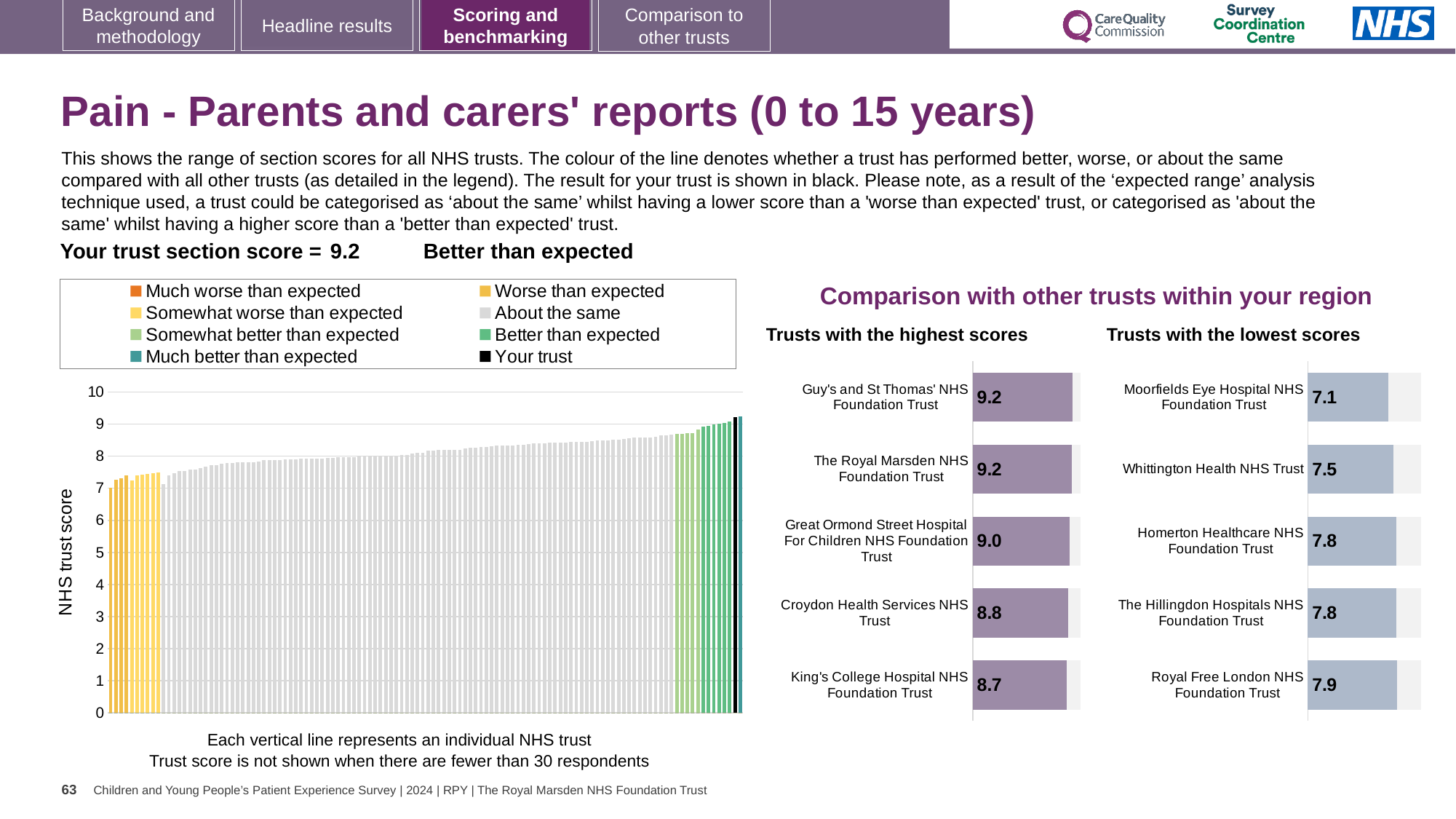
In the 'Trusts with the highest scores' chart, what is the score for Great Ormond Street Hospital For Children NHS Foundation Trust? 9.0 In the 'Trusts with the highest scores' chart, what is the difference between the scores of Guy's and St Thomas' NHS Foundation Trust and King's College Hospital NHS Foundation Trust? 0.5 How many trusts are listed in the 'Trusts with the highest scores' chart? 5 What is the y-axis label of the large chart on the left? NHS trust score How many entries does the legend above the large chart on the left list? 8 In the 'Trusts with the lowest scores' chart, which has the higher score: Whittington Health NHS Trust or Homerton Healthcare NHS Foundation Trust? Homerton Healthcare NHS Foundation Trust What kind of chart is the large chart on the left showing NHS trust scores? Bar chart In the 'Trusts with the lowest scores' chart, what is the difference between the scores of Royal Free London NHS Foundation Trust and Moorfields Eye Hospital NHS Foundation Trust? 0.8 In the large chart on the left, is the value of the leftmost (lowest) bar greater or less than 8? less In the 'Trusts with the lowest scores' chart, which trust has the lowest score? Moorfields Eye Hospital NHS Foundation Trust In the large chart on the left, do the trust scores rise or fall from left to right? Rise In the 'Trusts with the lowest scores' chart, what is the score for Moorfields Eye Hospital NHS Foundation Trust? 7.1